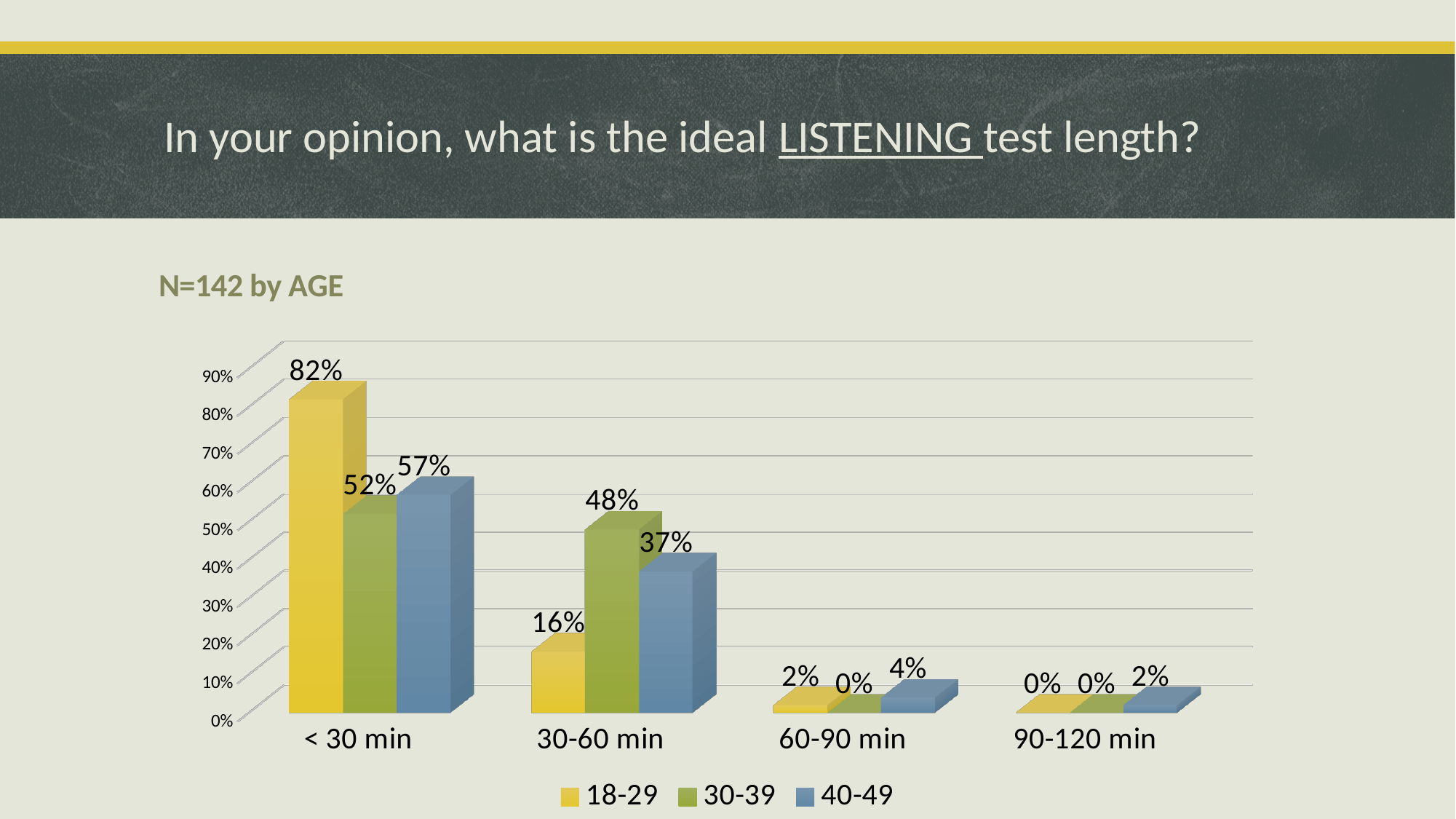
What is the value for the 30-39 series in the 60-90 min category? 0% Do the values for the 18-29 series rise or fall from < 30 min to 90-120 min? Fall What is the difference between the 18-29 and 30-39 values in the < 30 min category? 30% Which age group has the highest value in the < 30 min category? 18-29 What percentage of the 18-29 age group chose < 30 min as the ideal listening test length? 82% Which is larger in the 30-60 min category: the 30-39 value or the 40-49 value? 30-39 What is the subtitle shown above the chart? N=142 by AGE How many series does the legend list? 3 Which age group has the lowest value in the 30-60 min category? 18-29 How many test length categories are shown on the x axis? 4 What is the value for the 40-49 series in the 30-60 min category? 37% What kind of chart is shown on the slide? Bar chart